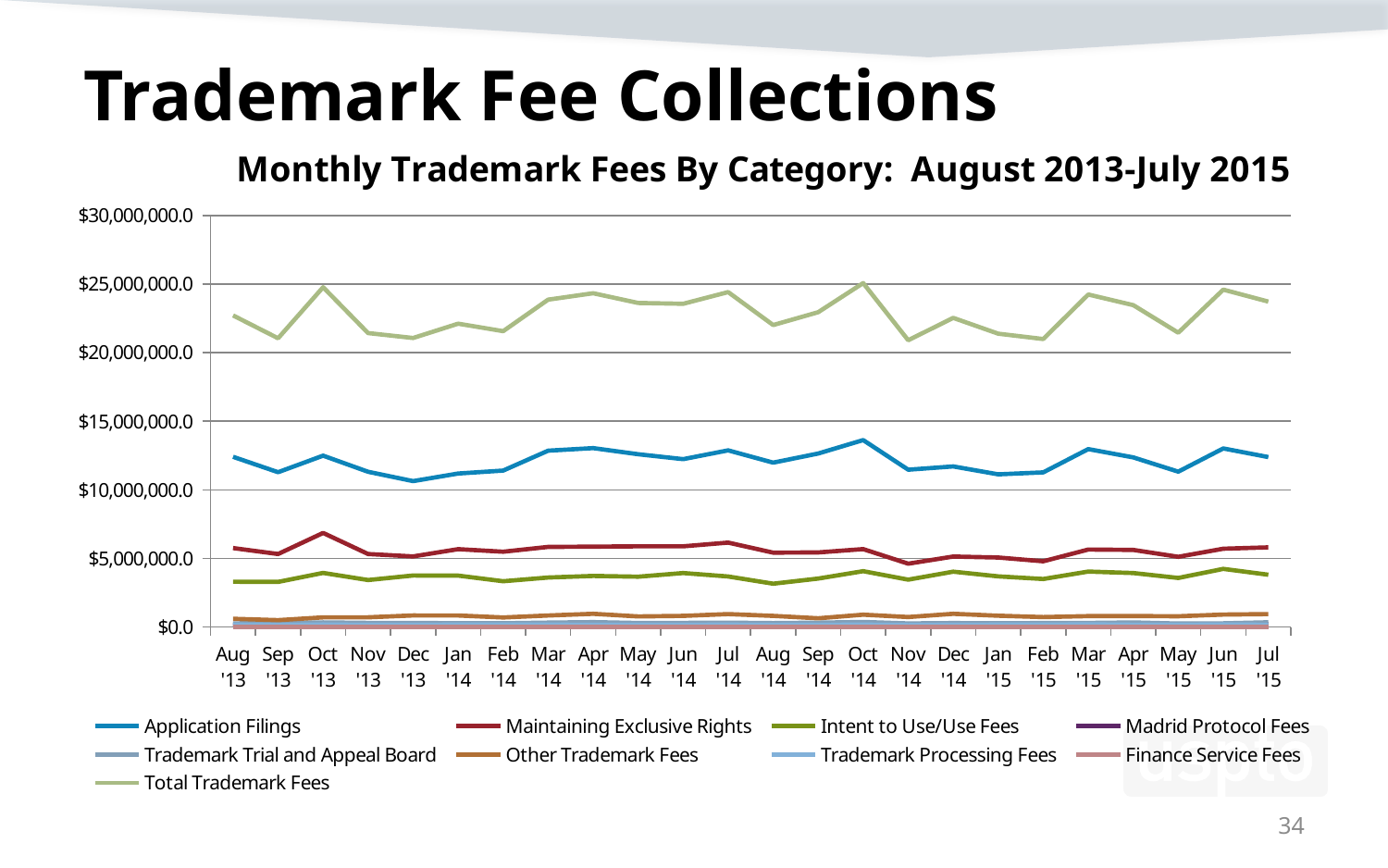
Which is larger in Jan '15: Application Filings or Maintaining Exclusive Rights? Application Filings In which month does Maintaining Exclusive Rights reach its highest value? Oct '13 Does Total Trademark Fees rise or fall from Sep '13 to Oct '13? Rise Is the value for Maintaining Exclusive Rights in Oct '13 greater or less than $5,000,000.0? greater Is the value for Intent to Use/Use Fees in Aug '13 greater or less than $5,000,000.0? less What kind of chart is shown on the slide? Line chart How many series does the legend list? 9 Is the value for Application Filings in Oct '14 greater or less than $10,000,000.0? greater Which series is plotted as the topmost line on the chart? Total Trademark Fees How many months are plotted along the x axis? 24 What is the title of the chart? Monthly Trademark Fees By Category: August 2013-July 2015